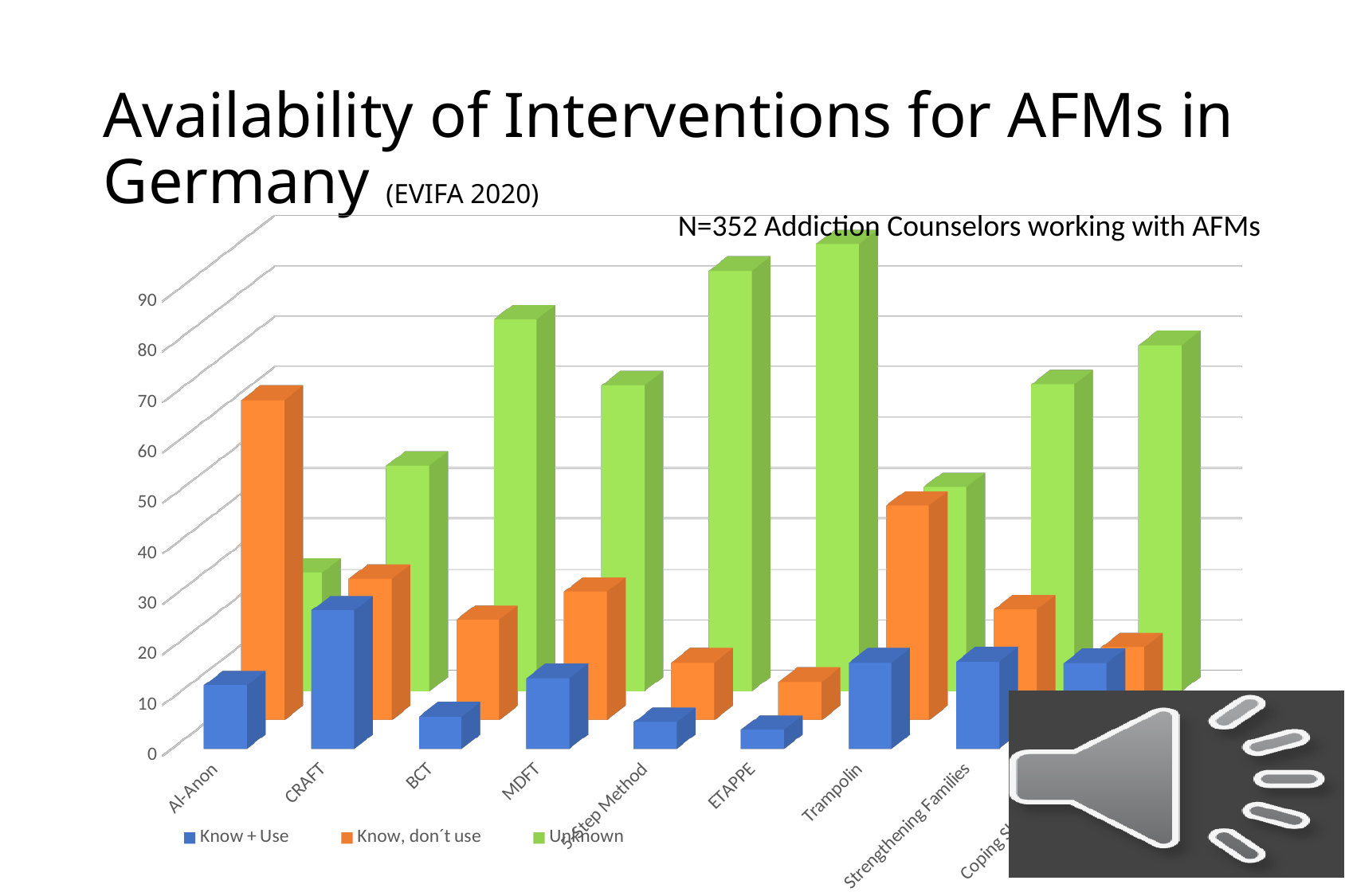
Which is larger: the "Know, don´t use" value for Al-Anon or for CRAFT? Al-Anon According to the text above the chart, how many addiction counselors were surveyed? N=352 Is the "Unknown" value for ETAPPE greater or less than 80? greater What are the three series named in the legend? Know + Use, Know, don´t use, Unknown Which intervention has the highest "Know + Use" bar? CRAFT What kind of chart is shown on the slide? bar chart How many series does the chart's legend list? 3 Which intervention has the highest "Know, don´t use" bar? Al-Anon Is the "Know + Use" value for BCT greater or less than 10? less Which intervention has the lowest "Unknown" bar? Al-Anon Which is larger: the "Unknown" value for ETAPPE or for CRAFT? ETAPPE Is the "Know, don´t use" value for Al-Anon greater or less than 50? greater